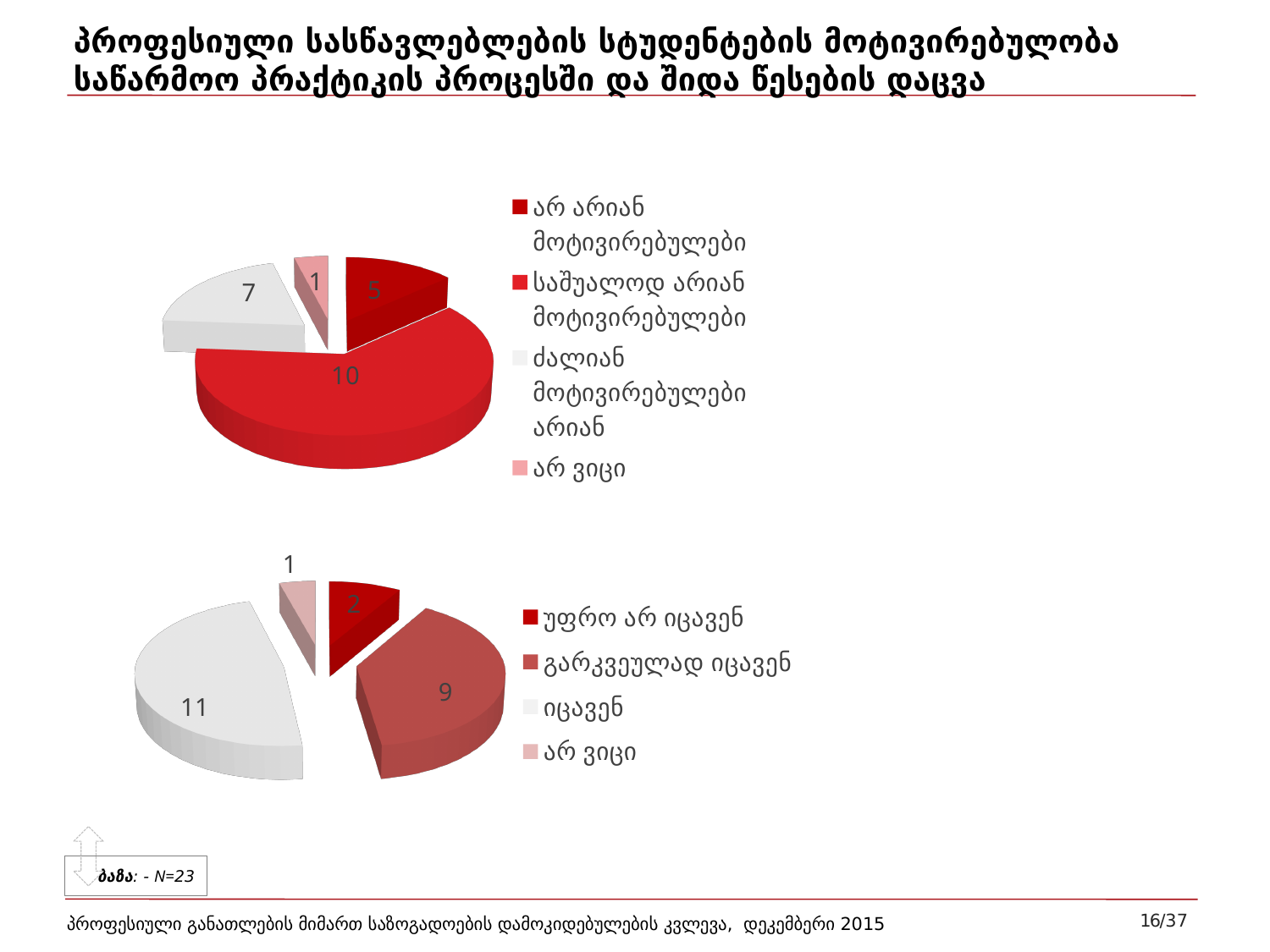
In the top pie chart, what is the value for "ძალიან მოტივირებულები არიან"? 7 In the top pie chart, what is the value for "საშუალოდ არიან მოტივირებულები"? 10 In the top pie chart, what is the difference between the values for "საშუალოდ არიან მოტივირებულები" and "არ არიან მოტივირებულები"? 5 In the bottom pie chart, which is larger: "გარკვეულად იცავენ" or "უფრო არ იცავენ"? გარკვეულად იცავენ In the bottom pie chart, what is the difference between the values for "იცავენ" and "გარკვეულად იცავენ"? 2 In the top pie chart, which category has the largest slice? საშუალოდ არიან მოტივირებულები In the top pie chart, how many categories does the legend list? 4 In the bottom pie chart, what is the value for "იცავენ"? 11 In the bottom pie chart, what is the value for "უფრო არ იცავენ"? 2 In the top pie chart, which category has the smallest slice? არ ვიცი In the bottom pie chart, which category has the largest slice? იცავენ What type of chart is the bottom chart on the slide? Pie chart